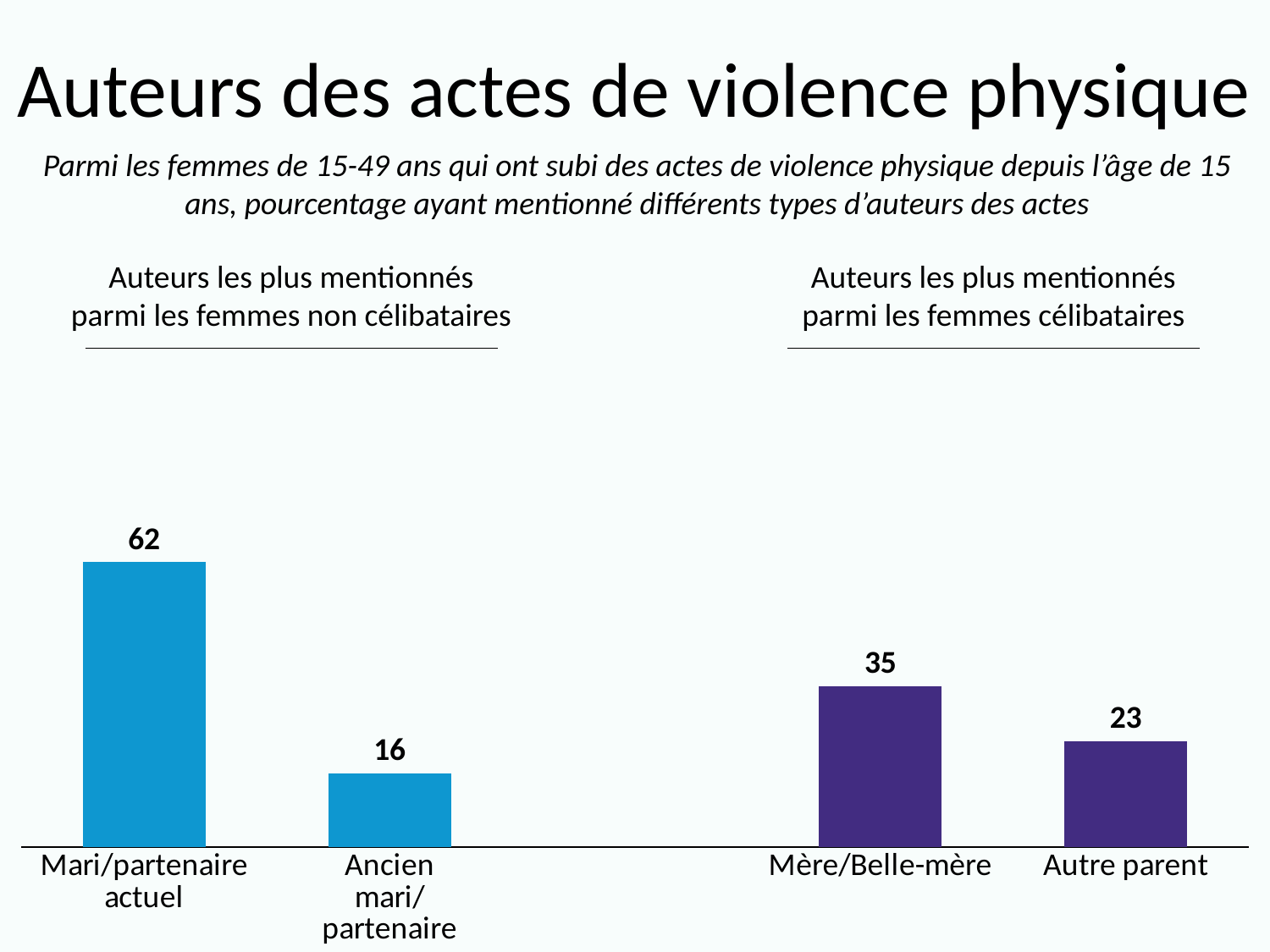
What is the value for Autre parent? 23 Which category has the highest value on the chart? Mari/partenaire actuel What is the difference between the values for Mère/Belle-mère and Autre parent? 12 What kind of chart is shown on the slide? Bar chart What is the value for Mère/Belle-mère? 35 What is the value for Ancien mari/partenaire? 16 Which is larger, the value for Mère/Belle-mère or the value for Autre parent? Mère/Belle-mère What is the heading above the two purple bars? Auteurs les plus mentionnés parmi les femmes célibataires Which category has the lowest value on the chart? Ancien mari/partenaire What is the difference between the values for Mari/partenaire actuel and Ancien mari/partenaire? 46 What is the value for Mari/partenaire actuel? 62 How many bars are plotted on the chart? 4